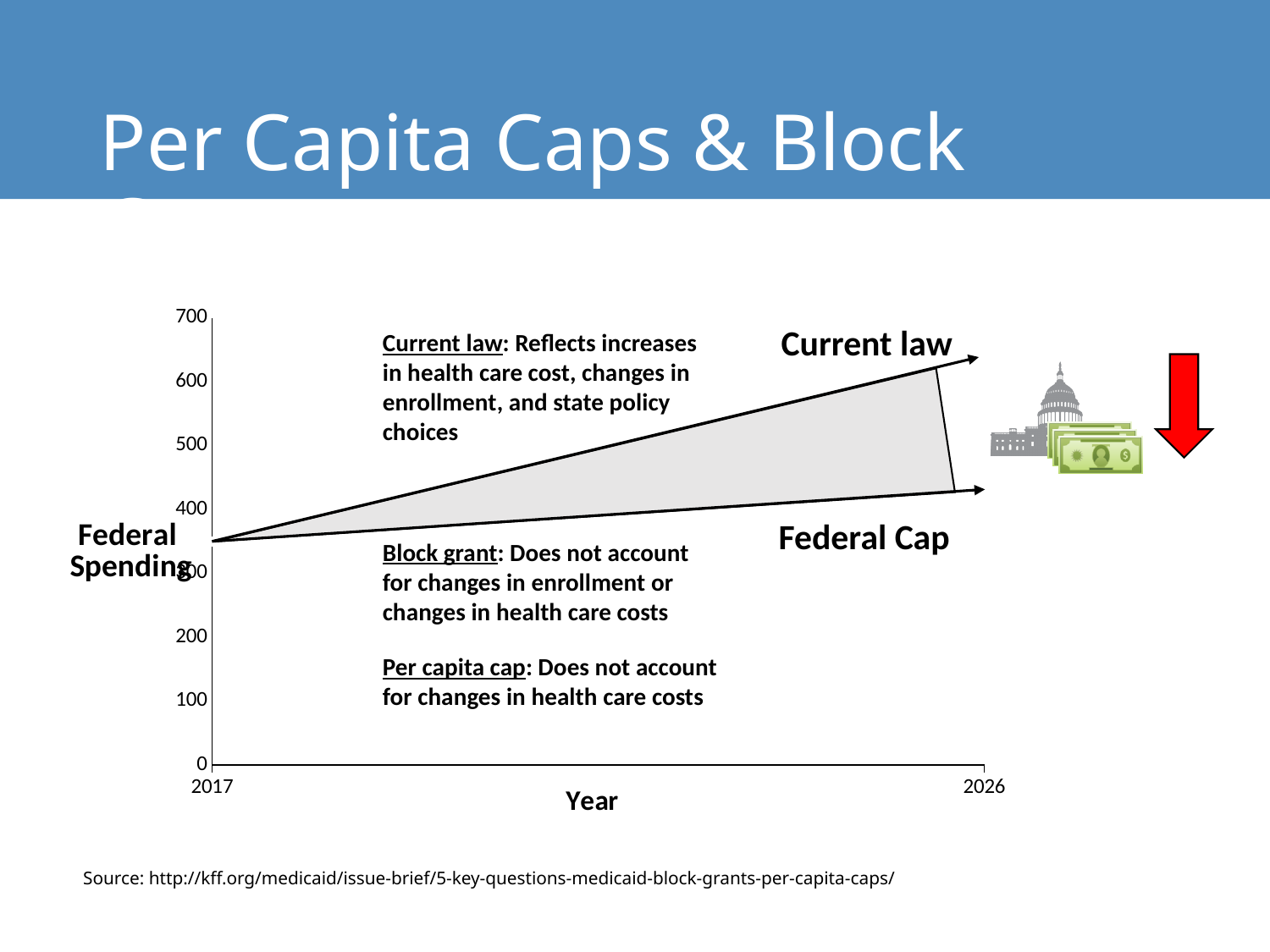
Does the Current law line rise or fall from 2017 to 2026? rise What is the label of the x axis? Year Is the starting value of the lines in 2017 greater or less than 400? less What is the label of the y axis? Federal Spending Does the Federal Cap line rise or fall from 2017 to 2026? rise Which two years are marked on the x axis? 2017 and 2026 Is the value for Federal Cap in 2026 greater or less than 500? less Is the starting value of the lines in 2017 greater or less than 300? greater In 2026, which line is higher, Current law or Federal Cap? Current law What kind of chart is shown on the slide? line chart What is the highest value shown on the y axis? 700